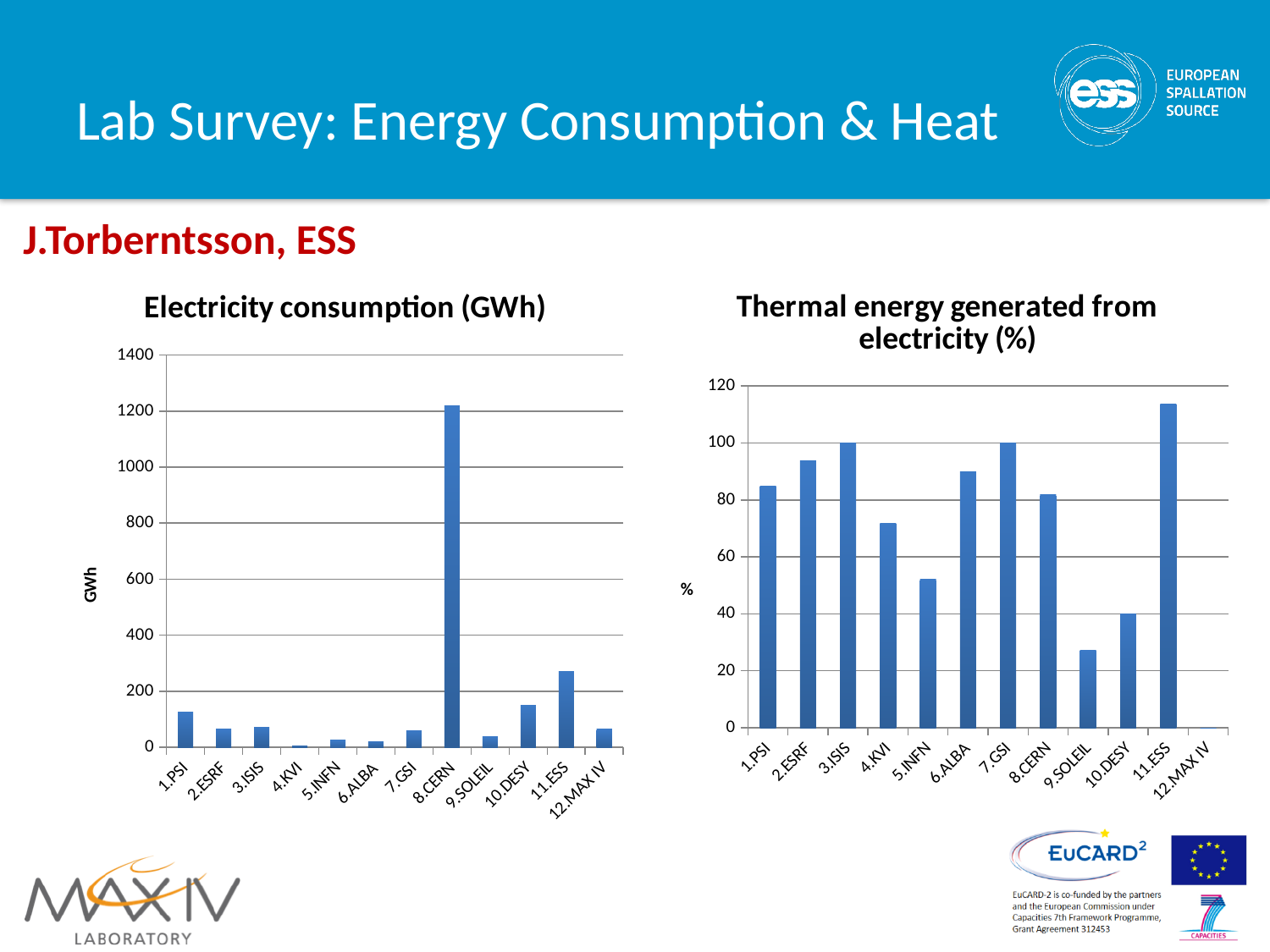
In the Electricity consumption (GWh) chart, is the value for 11.ESS greater or less than 200? greater In the Electricity consumption (GWh) chart, is the value for 8.CERN greater or less than 1000? greater How many labs are shown in the Electricity consumption (GWh) chart? 12 In the Electricity consumption (GWh) chart, which is larger, the value for 11.ESS or the value for 10.DESY? 11.ESS In the Electricity consumption (GWh) chart, which lab has the lowest electricity consumption? 4.KVI What kind of chart is the Thermal energy generated from electricity (%) chart? bar chart In the Thermal energy generated from electricity (%) chart, is the value for 5.INFN greater or less than 40? greater In the Thermal energy generated from electricity (%) chart, which lab has the highest value? 11.ESS In the Thermal energy generated from electricity (%) chart, which is larger, the value for 2.ESRF or the value for 4.KVI? 2.ESRF In the Electricity consumption (GWh) chart, which lab has the highest electricity consumption? 8.CERN In the Thermal energy generated from electricity (%) chart, which lab has the lowest value? 12.MAX IV